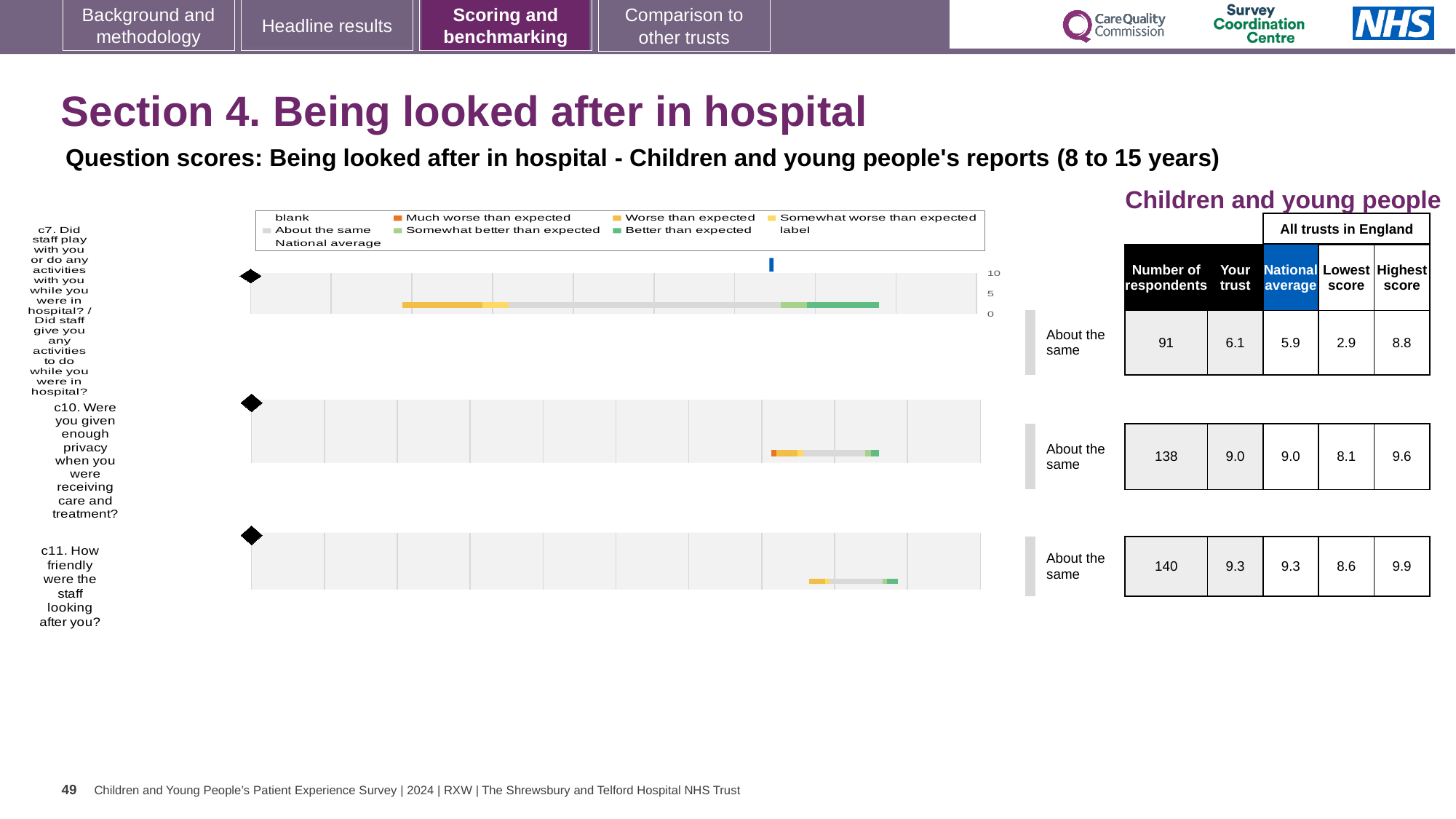
What colour does the legend use for 'Better than expected'? green What is the difference between the highest score and the lowest score across all trusts in England for question c7? 5.9 How many questions are plotted in the chart on this slide? 3 Which question has the highest 'Your trust' score? c11. How friendly were the staff looking after you? What is the 'Your trust' score for question c10 (Were you given enough privacy when you were receiving care and treatment?)? 9.0 How many respondents answered question c7 (Did staff play with you or do any activities with you while you were in hospital?)? 91 What is the national average score for question c11 (How friendly were the staff looking after you?)? 9.3 What is the lowest score across all trusts in England for question c11? 8.6 What kind of chart is used to show the question scores on this slide? bar chart For question c7, which is larger: the 'Your trust' score or the national average? Your trust Which question has the lowest 'Your trust' score? c7. Did staff play with you or do any activities with you while you were in hospital? What benchmark category is shown for question c10? About the same